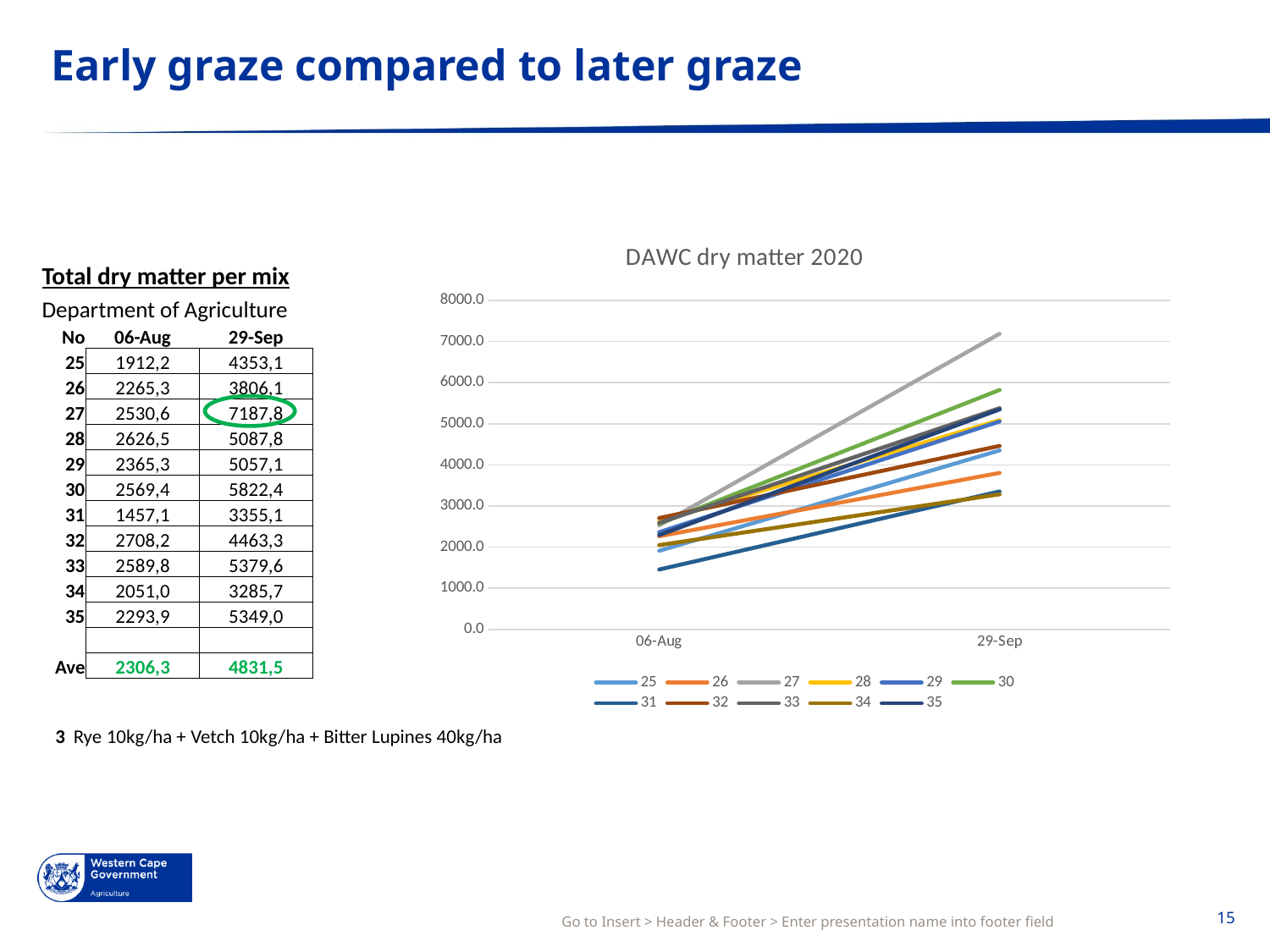
In the 'DAWC dry matter 2020' chart, do the lines rise or fall from 06-Aug to 29-Sep? rise In the 'DAWC dry matter 2020' chart, which is larger at 29-Sep: series 27 or series 30? 27 According to the table on the slide, what is the 29-Sep value for mix 27? 7187,8 What is the title of the line chart on the slide? DAWC dry matter 2020 In the 'DAWC dry matter 2020' chart, is the value for series 31 at 06-Aug greater or less than 2000.0? less In the 'DAWC dry matter 2020' chart, which series has the highest value at 29-Sep? 27 How many dates are shown on the x axis of the 'DAWC dry matter 2020' chart? 2 What kind of chart is the 'DAWC dry matter 2020' chart? line chart In the 'DAWC dry matter 2020' chart, is the value for series 27 at 29-Sep greater or less than 6000.0? greater In the 'DAWC dry matter 2020' chart, which series has the lowest value at 06-Aug? 31 In the 'DAWC dry matter 2020' chart, is the value for series 30 at 29-Sep greater or less than 5000.0? greater How many series does the legend of the 'DAWC dry matter 2020' chart list? 11